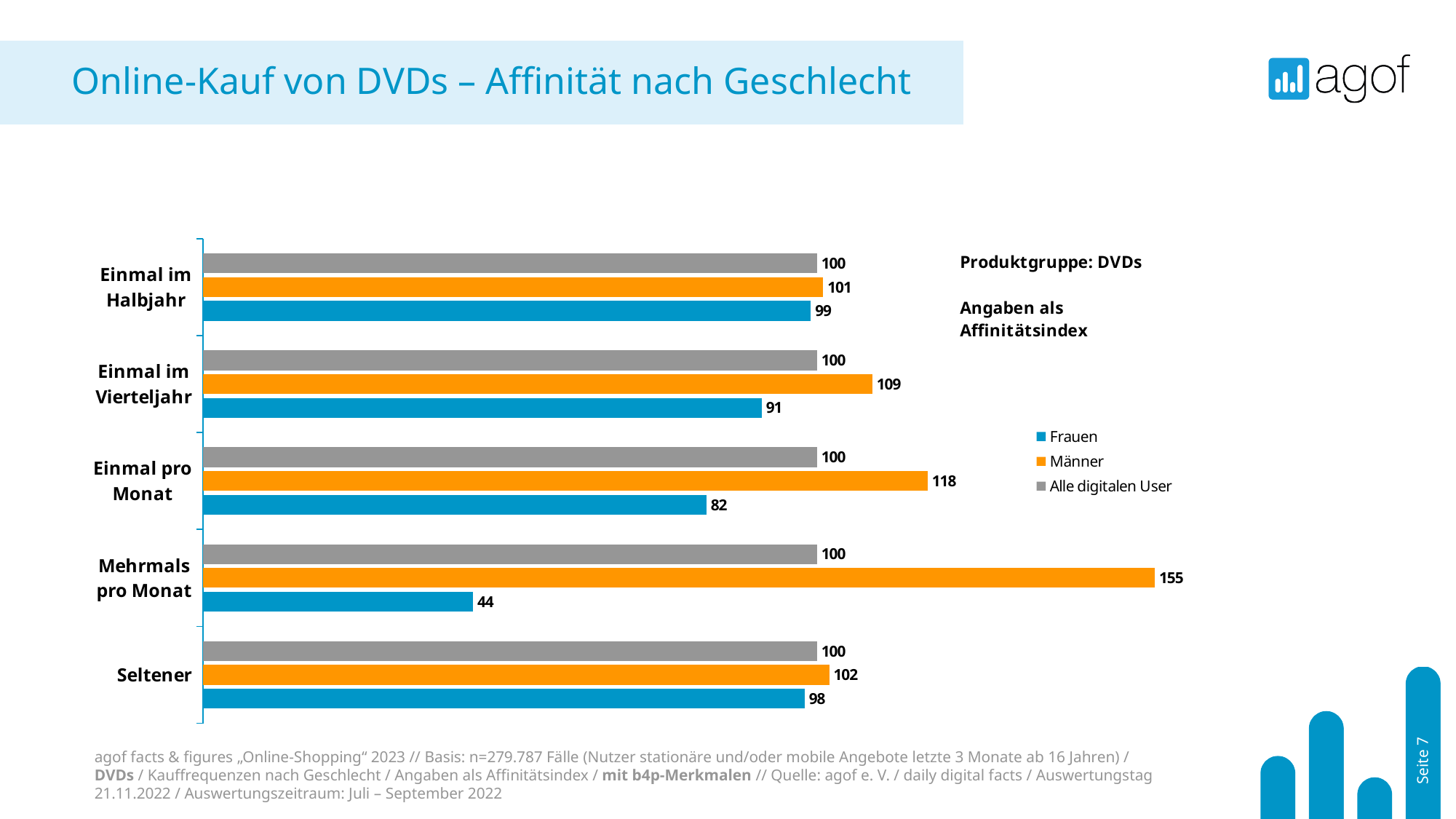
What is the Frauen value for Einmal im Vierteljahr? 91 What is the Männer value for Mehrmals pro Monat? 155 What is the difference between the Männer and Frauen values for Einmal pro Monat? 36 What is the difference between the Männer and Frauen values for Mehrmals pro Monat? 111 What is the Frauen value for Einmal pro Monat? 82 Which category has the lowest Frauen value? Mehrmals pro Monat How many series does the legend list? 3 What kind of chart is shown on the slide? Bar chart Which colour represents Männer in the chart? Orange Which category has the highest Männer value? Mehrmals pro Monat How many categories are shown on the chart? 5 Which is larger, the Frauen value for Seltener or the Frauen value for Einmal im Halbjahr? Einmal im Halbjahr